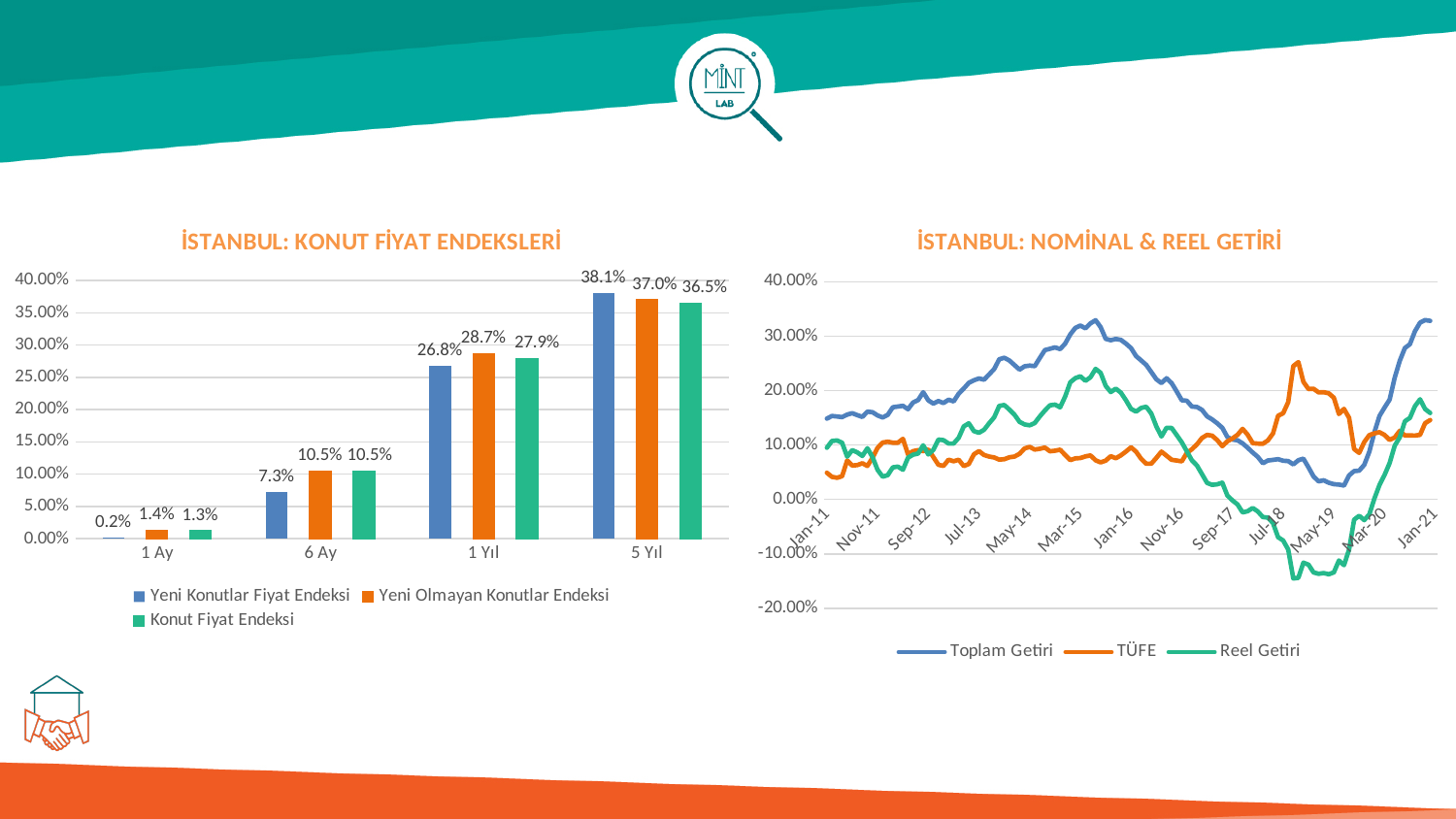
In the chart titled 'İSTANBUL: KONUT FİYAT ENDEKSLERİ', what is the value of Konut Fiyat Endeksi for 6 Ay? 10.5% In the chart titled 'İSTANBUL: KONUT FİYAT ENDEKSLERİ', which category has the lowest value for Yeni Konutlar Fiyat Endeksi? 1 Ay In the chart titled 'İSTANBUL: NOMİNAL & REEL GETİRİ', how many series does the legend list? 3 In the chart titled 'İSTANBUL: KONUT FİYAT ENDEKSLERİ', which is larger for 5 Yıl: Yeni Konutlar Fiyat Endeksi or Konut Fiyat Endeksi? Yeni Konutlar Fiyat Endeksi In the chart titled 'İSTANBUL: KONUT FİYAT ENDEKSLERİ', what is the value of Yeni Konutlar Fiyat Endeksi for 5 Yıl? 38.1% In the chart titled 'İSTANBUL: KONUT FİYAT ENDEKSLERİ', do the values of Yeni Konutlar Fiyat Endeksi rise or fall from 1 Ay to 5 Yıl? rise In the chart titled 'İSTANBUL: KONUT FİYAT ENDEKSLERİ', how many categories are shown on the x axis? 4 In the chart titled 'İSTANBUL: KONUT FİYAT ENDEKSLERİ', which category has the highest value for Konut Fiyat Endeksi? 5 Yıl In the chart titled 'İSTANBUL: KONUT FİYAT ENDEKSLERİ', what is the value of Yeni Olmayan Konutlar Endeksi for 1 Yıl? 28.7% In the chart titled 'İSTANBUL: KONUT FİYAT ENDEKSLERİ', what is the difference between Yeni Olmayan Konutlar Endeksi and Yeni Konutlar Fiyat Endeksi for 6 Ay? 3.2% What kind of chart is the one titled 'İSTANBUL: NOMİNAL & REEL GETİRİ'? line chart In the chart titled 'İSTANBUL: NOMİNAL & REEL GETİRİ', is the value of Toplam Getiri at Jan-21 greater or less than 30.00%? greater